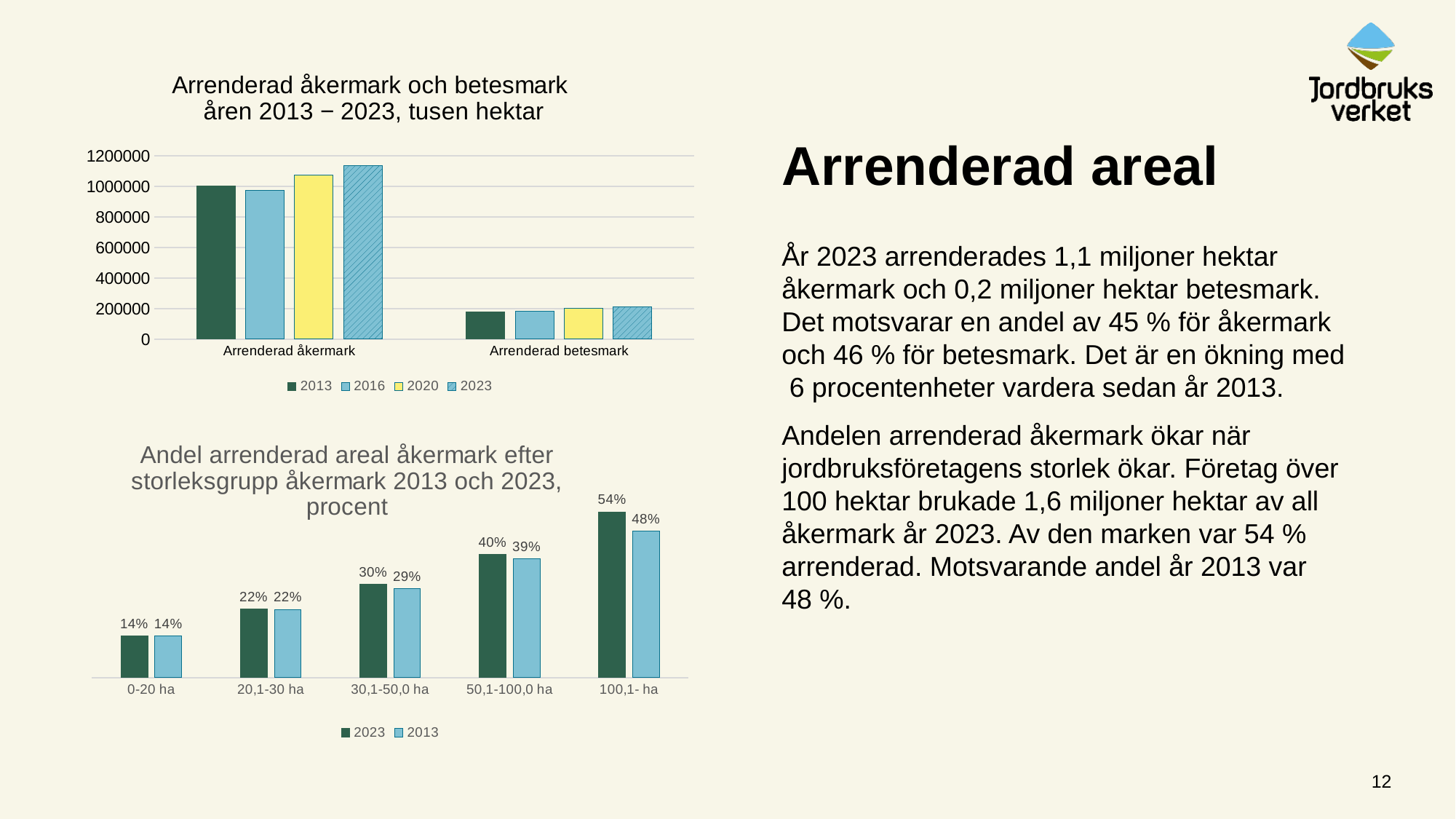
In the bottom chart (Andel arrenderad areal åkermark efter storleksgrupp), what is the difference between the 2023 and 2013 values for the 100,1- ha group? 6 percentage points In the bottom chart (Andel arrenderad areal åkermark efter storleksgrupp), is the 2023 value or the 2013 value larger for the 50,1-100,0 ha group? 2023 How many size groups are shown in the bottom chart (Andel arrenderad areal åkermark efter storleksgrupp)? 5 In the bottom chart (Andel arrenderad areal åkermark efter storleksgrupp), what is the value for 2023 in the 100,1- ha group? 54% In the bottom chart (Andel arrenderad areal åkermark efter storleksgrupp), what is the value for 2013 in the 30,1-50,0 ha group? 29% In the bottom chart (Andel arrenderad areal åkermark efter storleksgrupp), which size group has the lowest value for 2013? 0-20 ha What kind of chart is the top chart (Arrenderad åkermark och betesmark åren 2013 − 2023)? bar chart How many series does the legend of the top chart (Arrenderad åkermark och betesmark åren 2013 − 2023) list? 4 In the bottom chart (Andel arrenderad areal åkermark efter storleksgrupp), which size group has the highest value for 2023? 100,1- ha In the bottom chart (Andel arrenderad areal åkermark efter storleksgrupp), do the 2023 values rise or fall as the size group increases? rise In the top chart (Arrenderad åkermark och betesmark åren 2013 − 2023), is the value for Arrenderad betesmark in 2013 greater or less than 400000? less In the top chart (Arrenderad åkermark och betesmark åren 2013 − 2023), is the value for Arrenderad åkermark in 2023 greater or less than 1000000? greater